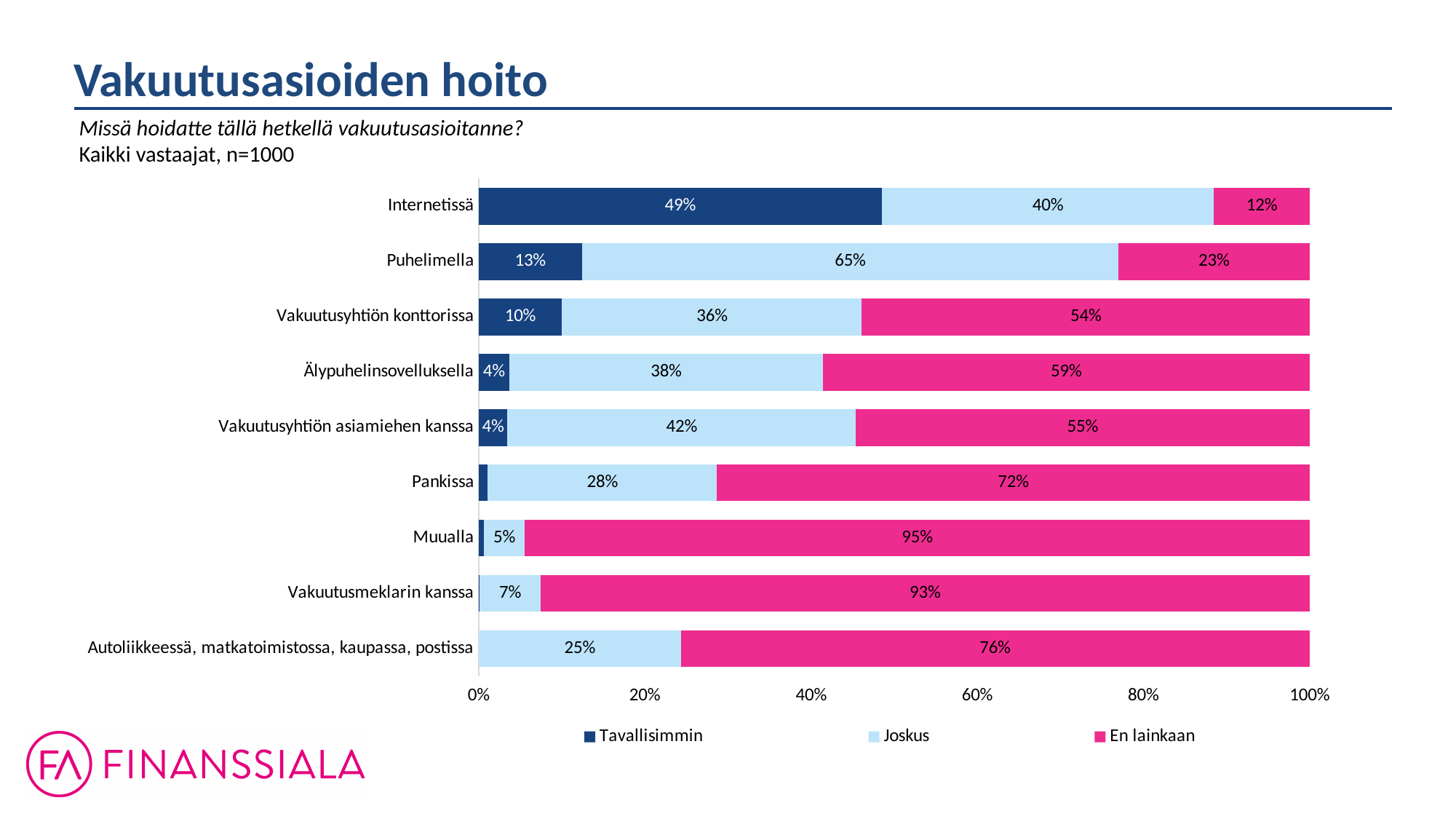
Which category has the highest 'Tavallisimmin' value? Internetissä What is the 'Tavallisimmin' value for Internetissä? 49% Which category has the highest 'En lainkaan' value? Muualla How many categories are shown on the chart? 9 What is the 'Joskus' value for Puhelimella? 65% Which category has the lowest 'En lainkaan' value? Internetissä What is the difference between the 'Joskus' value for Puhelimella and the 'Joskus' value for Internetissä? 25 percentage points What are the three legend entries of the chart? Tavallisimmin, Joskus, En lainkaan What is the 'En lainkaan' value for Pankissa? 72% How many series does the legend list? 3 What kind of chart is shown on the slide? Stacked bar chart Which has a larger 'En lainkaan' value: Älypuhelinsovelluksella or Vakuutusyhtiön asiamiehen kanssa? Älypuhelinsovelluksella